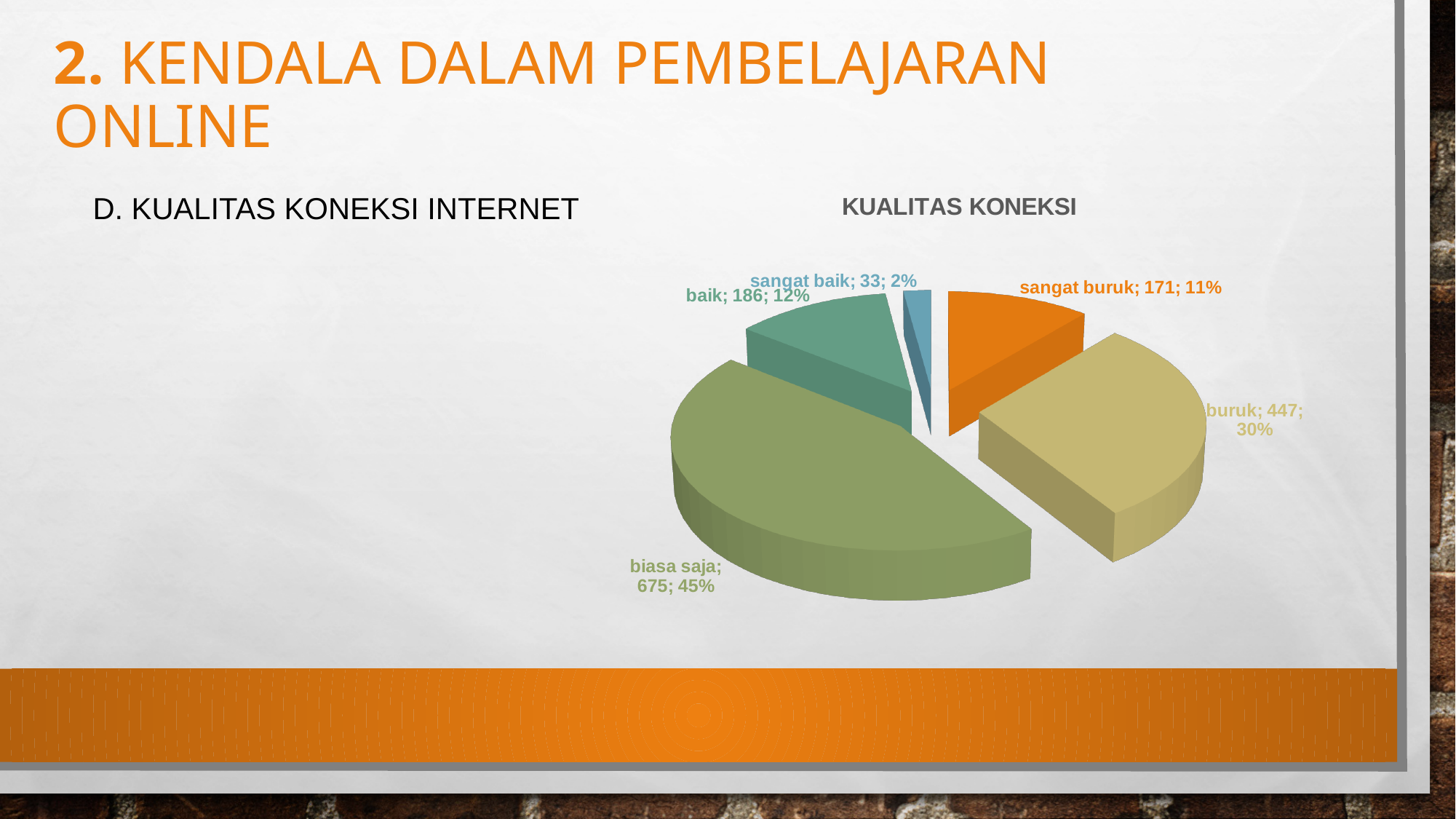
Which category has the smallest slice? sangat baik What share of the pie does 'sangat baik' represent? 2% Which is larger, the value for 'baik' or the value for 'sangat buruk'? baik What is the difference between the values for 'buruk' and 'sangat buruk'? 276 What is the value for 'baik'? 186 Which category has the largest slice? biasa saja What is the value for 'sangat buruk'? 171 What is the title of the chart? KUALITAS KONEKSI What is the value for 'biasa saja'? 675 How many slices does the pie chart have? 5 What share of the pie does 'buruk' represent? 30% What kind of chart is shown on the slide? pie chart